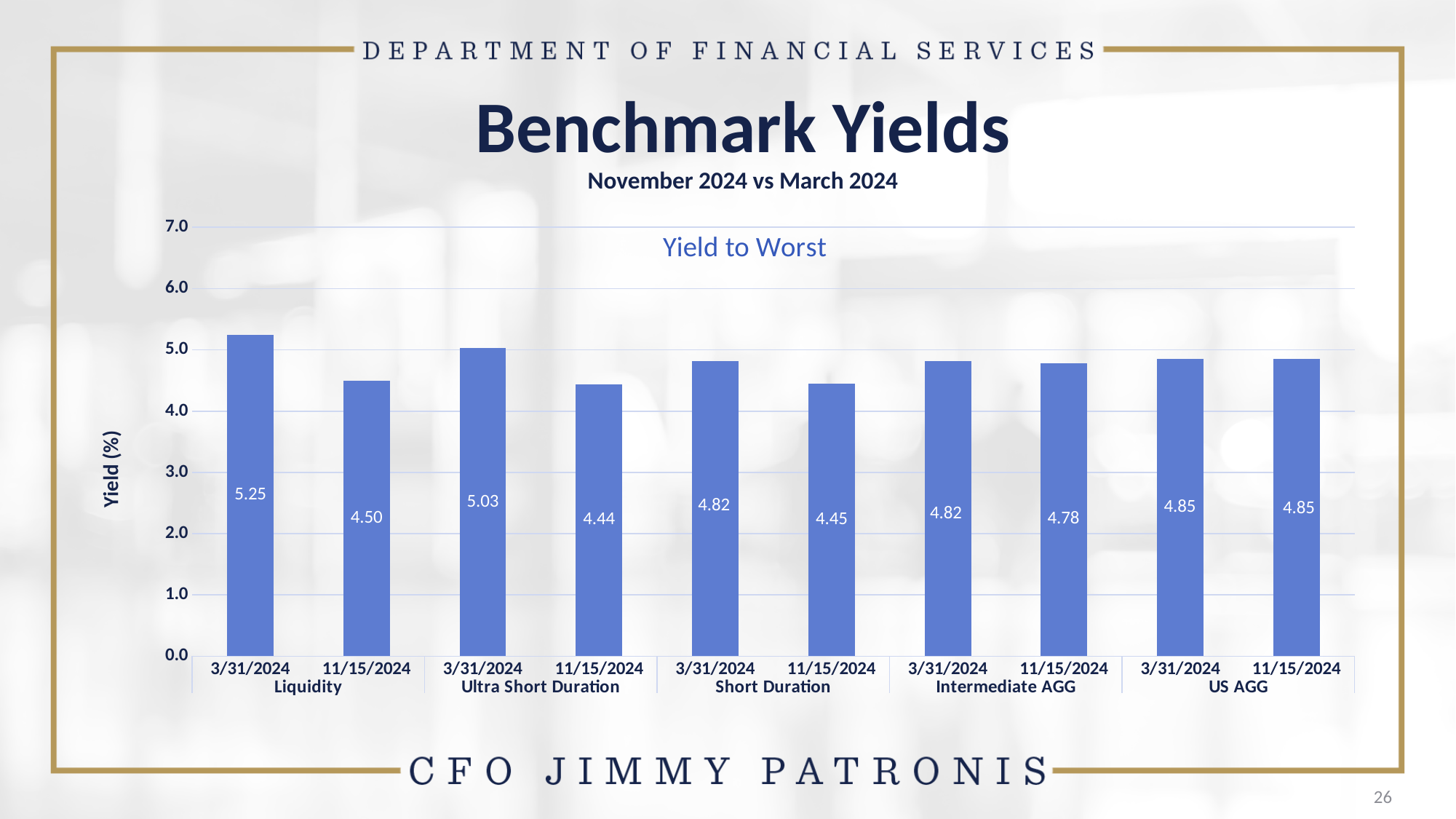
What is the label on the vertical axis of the chart? Yield (%) What is the difference between the Short Duration yield on 3/31/2024 and on 11/15/2024? 0.37 What kind of chart is shown on the slide? bar chart What is the difference between the Liquidity yield on 3/31/2024 and on 11/15/2024? 0.75 Which bar has the lowest Yield to Worst? Ultra Short Duration 11/15/2024 Is the value for Liquidity on 11/15/2024 greater or less than 5.0? less Which bar has the highest Yield to Worst? Liquidity 3/31/2024 What is the Yield to Worst for Liquidity on 3/31/2024? 5.25 Which is larger: the Ultra Short Duration yield on 3/31/2024 or the US AGG yield on 3/31/2024? Ultra Short Duration 3/31/2024 What is the Yield to Worst for Intermediate AGG on 11/15/2024? 4.78 How many bars are plotted in the chart? 10 What is the Yield to Worst for Ultra Short Duration on 11/15/2024? 4.44